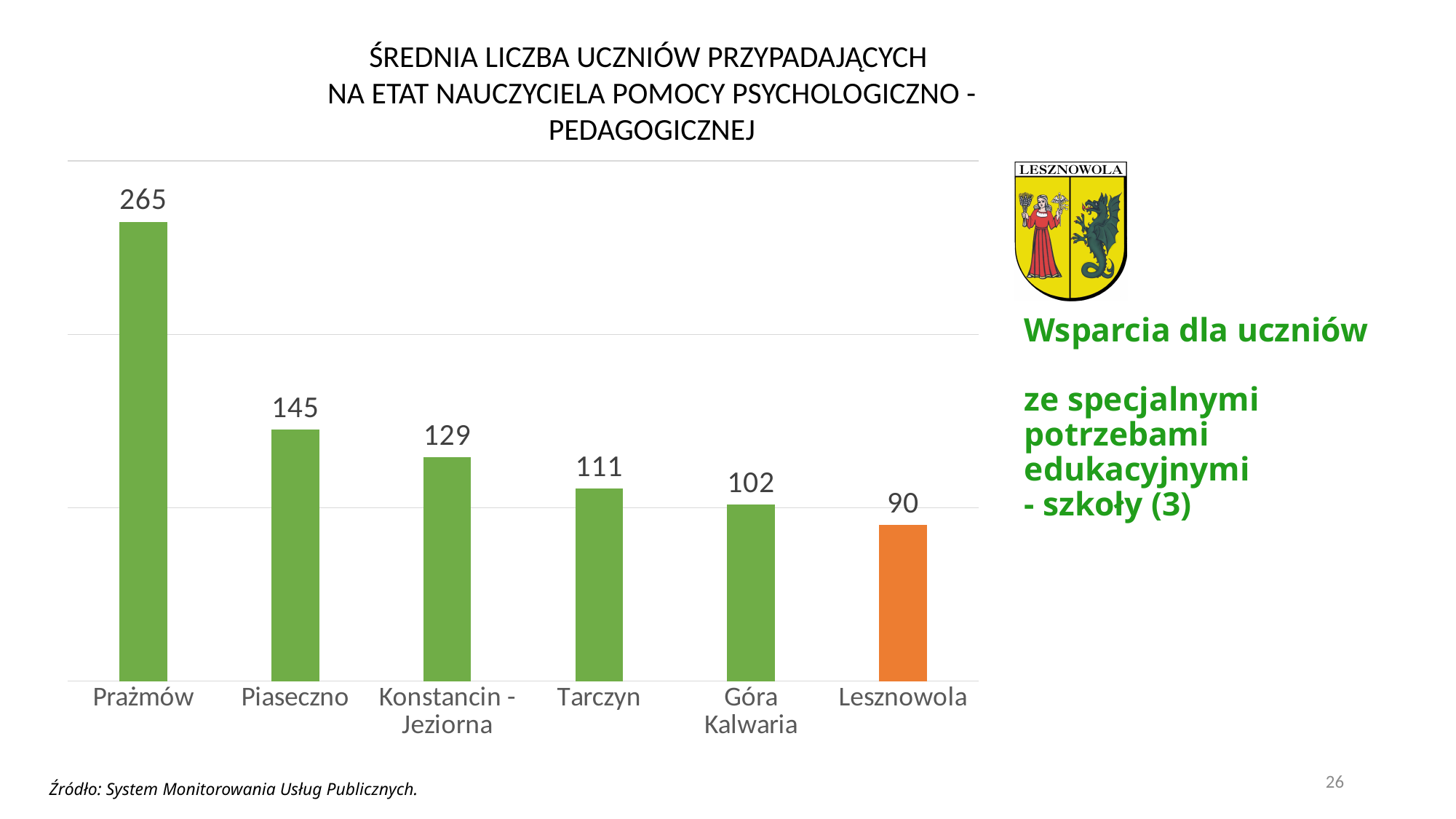
What is the value for Prażmów? 265 What is the value for Lesznowola? 90 Do the values rise or fall from left to right along the x axis? fall Which category has the highest value? Prażmów What is the difference between the values for Prażmów and Piaseczno? 120 Which bar is coloured orange instead of green? Lesznowola What is the difference between the values for Tarczyn and Lesznowola? 21 How many categories are shown on the chart? 6 Which is larger, the value for Góra Kalwaria or the value for Tarczyn? Tarczyn What is the value for Konstancin - Jeziorna? 129 Which category has the lowest value? Lesznowola What kind of chart is shown on the slide? bar chart